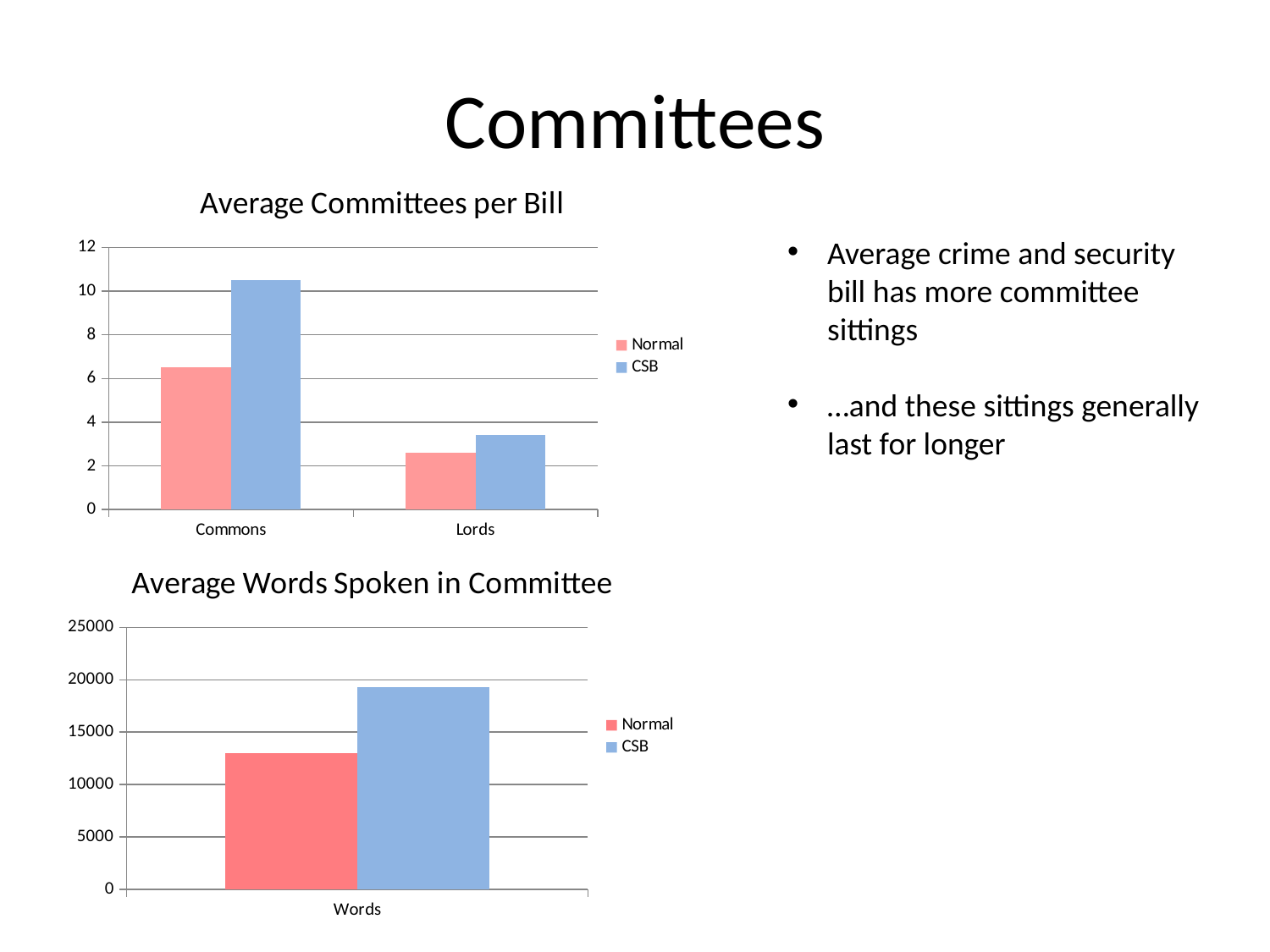
In the 'Average Words Spoken in Committee' chart, is the CSB value greater or less than 15000? greater In the 'Average Committees per Bill' chart, how many categories are shown on the x axis? 2 In the 'Average Committees per Bill' chart, how many series does the legend list? 2 In the 'Average Committees per Bill' chart, is the Normal value for Lords greater or less than 4? less In the 'Average Words Spoken in Committee' chart, is the Normal value greater or less than 15000? less In the 'Average Words Spoken in Committee' chart, what colour represents the CSB series? blue In the 'Average Committees per Bill' chart, which category has the lowest Normal value? Lords In the 'Average Words Spoken in Committee' chart, which series has the larger value, Normal or CSB? CSB In the 'Average Committees per Bill' chart, what kind of chart is shown? bar chart In the 'Average Committees per Bill' chart, which category has the highest CSB value? Commons In the 'Average Committees per Bill' chart, which is larger for Commons, Normal or CSB? CSB